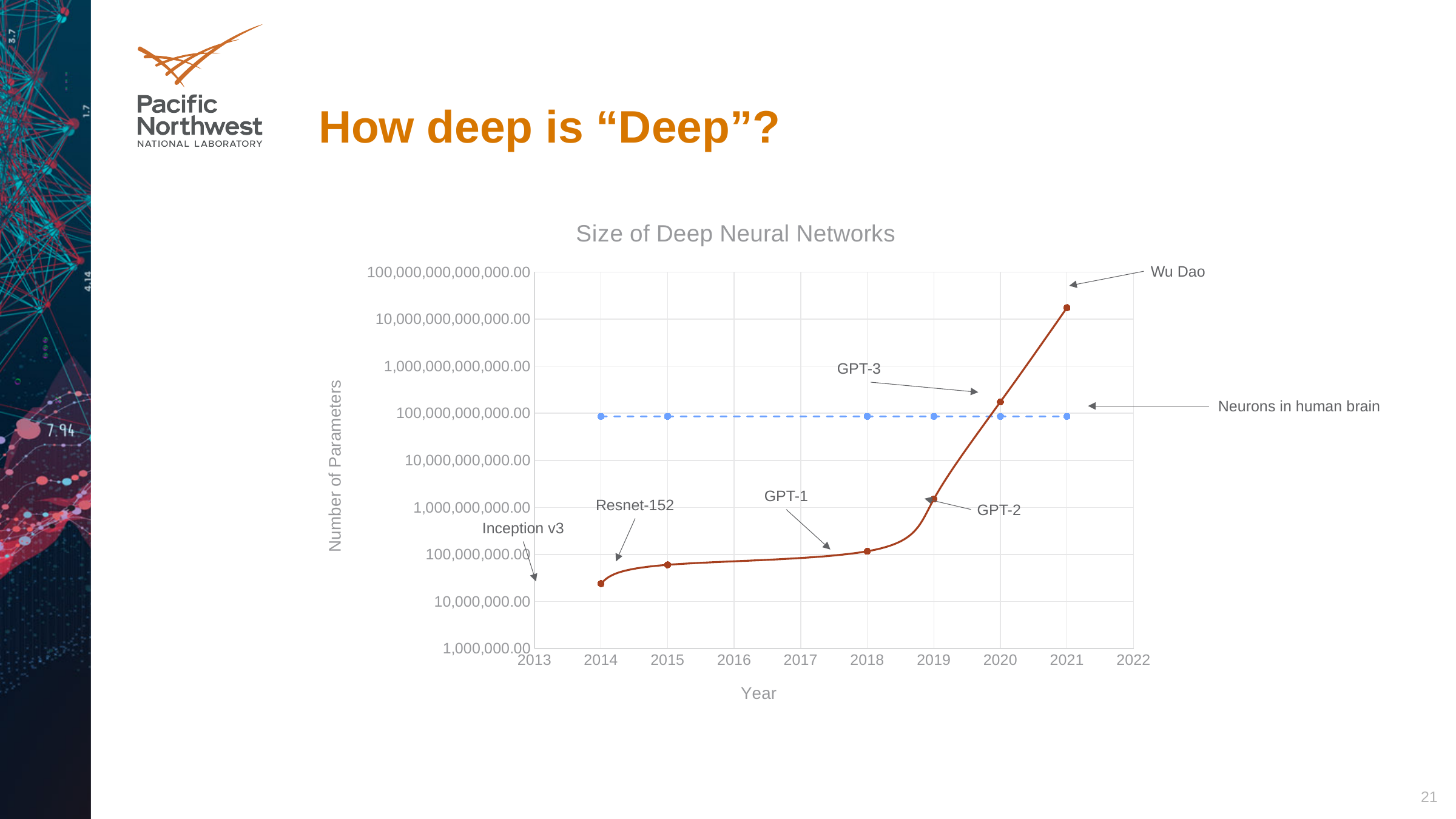
Is the value for Wu Dao greater or less than 10,000,000,000,000.00? greater What is the label of the vertical axis? Number of Parameters What kind of chart is shown on the slide? Line chart Which labelled network has the lowest number of parameters? Inception v3 Which is larger, the number of parameters of GPT-3 or the number of neurons in the human brain? GPT-3 Is the value for Resnet-152 greater or less than 100,000,000.00? less Which labelled network has the highest number of parameters? Wu Dao What is the title of the chart? Size of Deep Neural Networks How many data points are plotted on the red network-size line? 6 Does the number of parameters rise or fall from 2014 to 2021? Rise Is the value for GPT-2 greater or less than 10,000,000,000.00? less